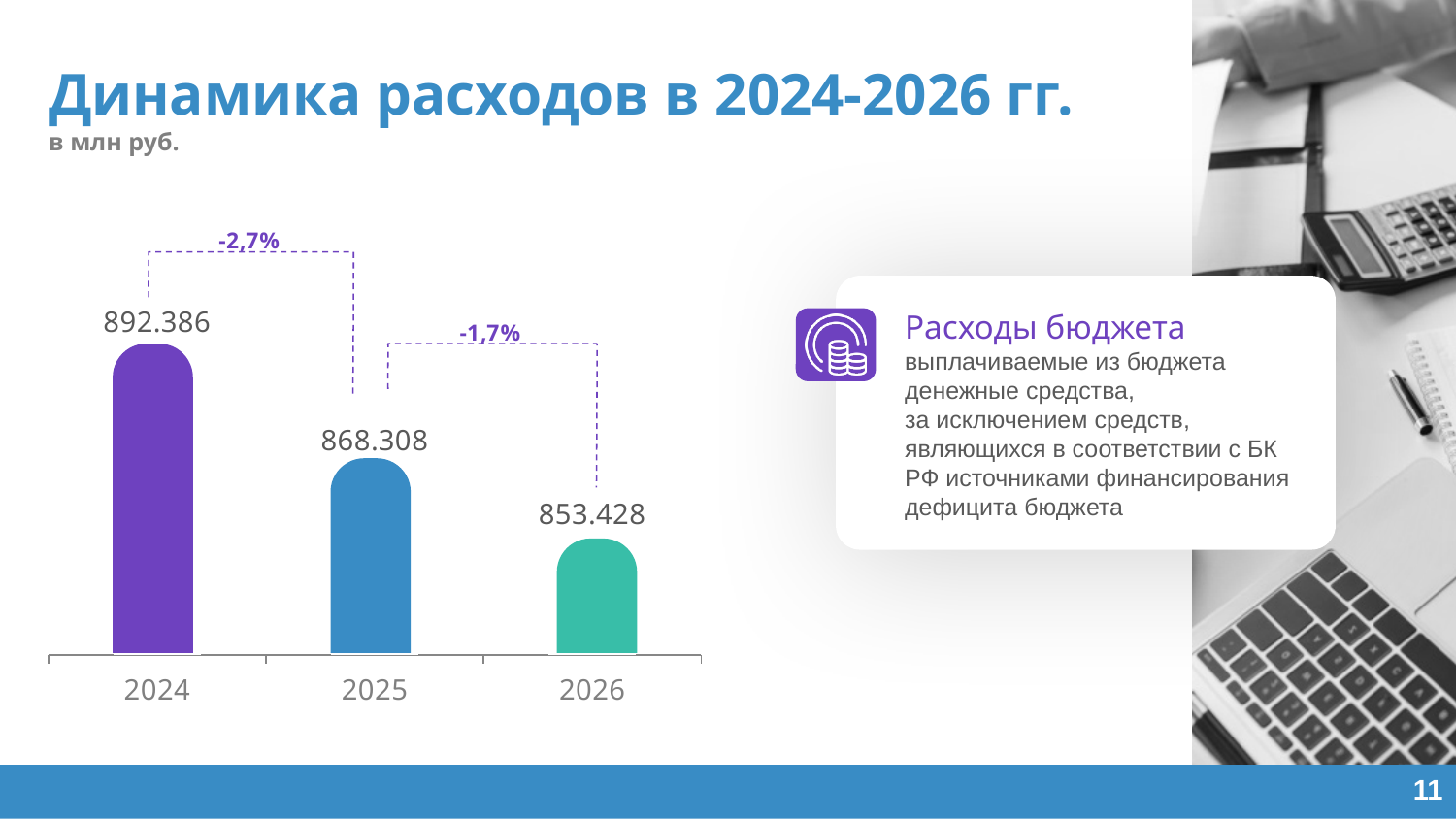
Do the values rise or fall from 2024 to 2026? fall What is the difference between the values for 2025 and 2026? 14.880 What kind of chart is shown on the slide? bar chart How many years are shown on the chart? 3 What percentage change is annotated between 2024 and 2025? -2,7% What is the value for 2024? 892.386 What is the value for 2026? 853.428 What is the difference between the values for 2024 and 2025? 24.078 Which year has the highest value? 2024 Which year has the lowest value? 2026 What is the value for 2025? 868.308 Which is larger, the value for 2024 or the value for 2026? 2024